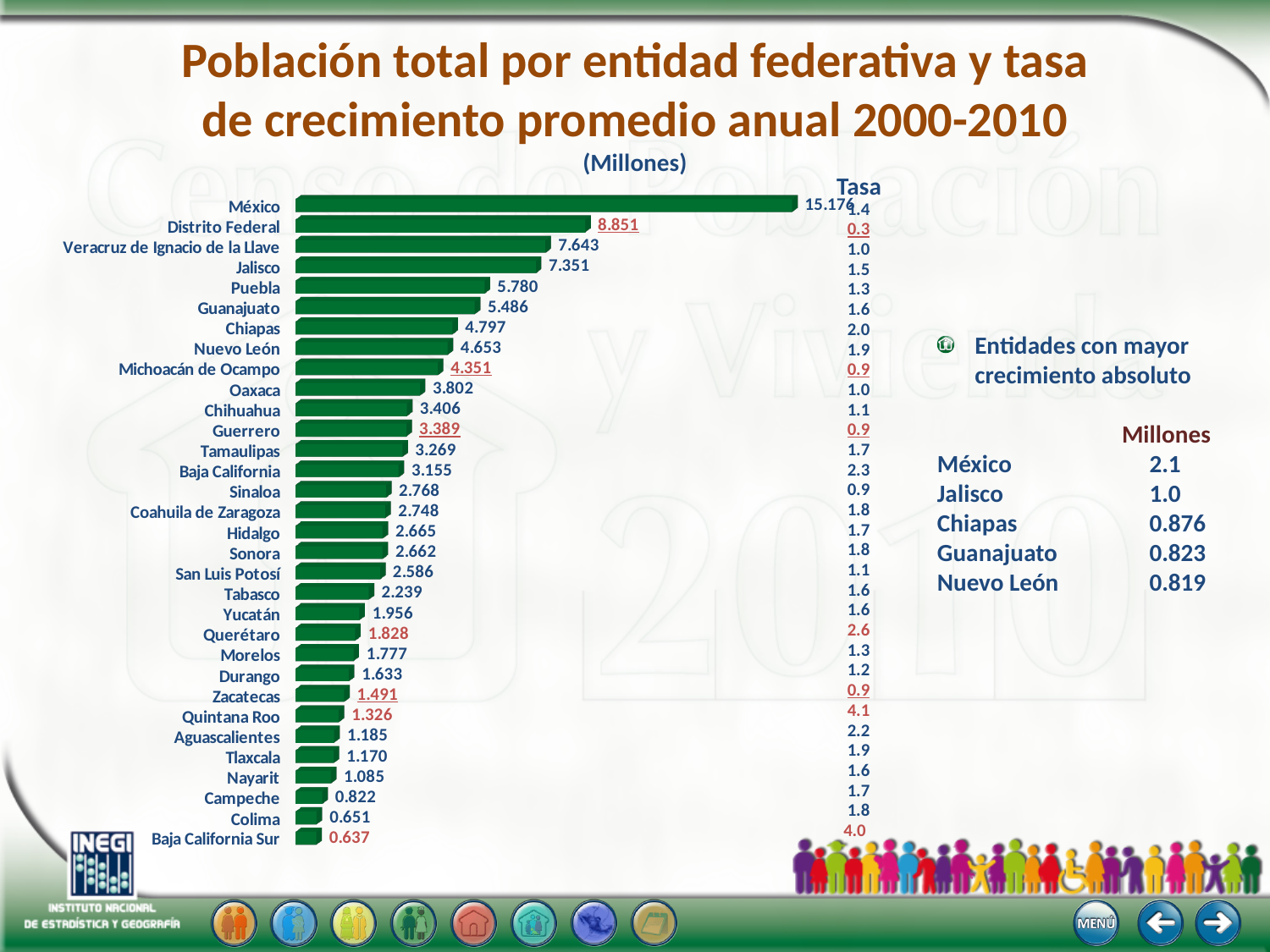
What is the population value shown for Distrito Federal? 8.851 What is the difference between the population values of Distrito Federal and Veracruz de Ignacio de la Llave? 1.208 Which has a larger population value, Oaxaca or Chihuahua? Oaxaca What is the population value shown for Zacatecas? 1.491 Which entity has the largest population in the chart? México What is the population value shown for Jalisco? 7.351 How many entities (bars) are shown in the chart? 32 What is the 'Tasa' (growth rate) shown for Quintana Roo? 4.1 Which entity has the smallest population in the chart? Baja California Sur What is the difference between the population values of Jalisco and Puebla? 1.571 What type of chart is shown on the slide? bar chart What is the population value shown for Colima? 0.651